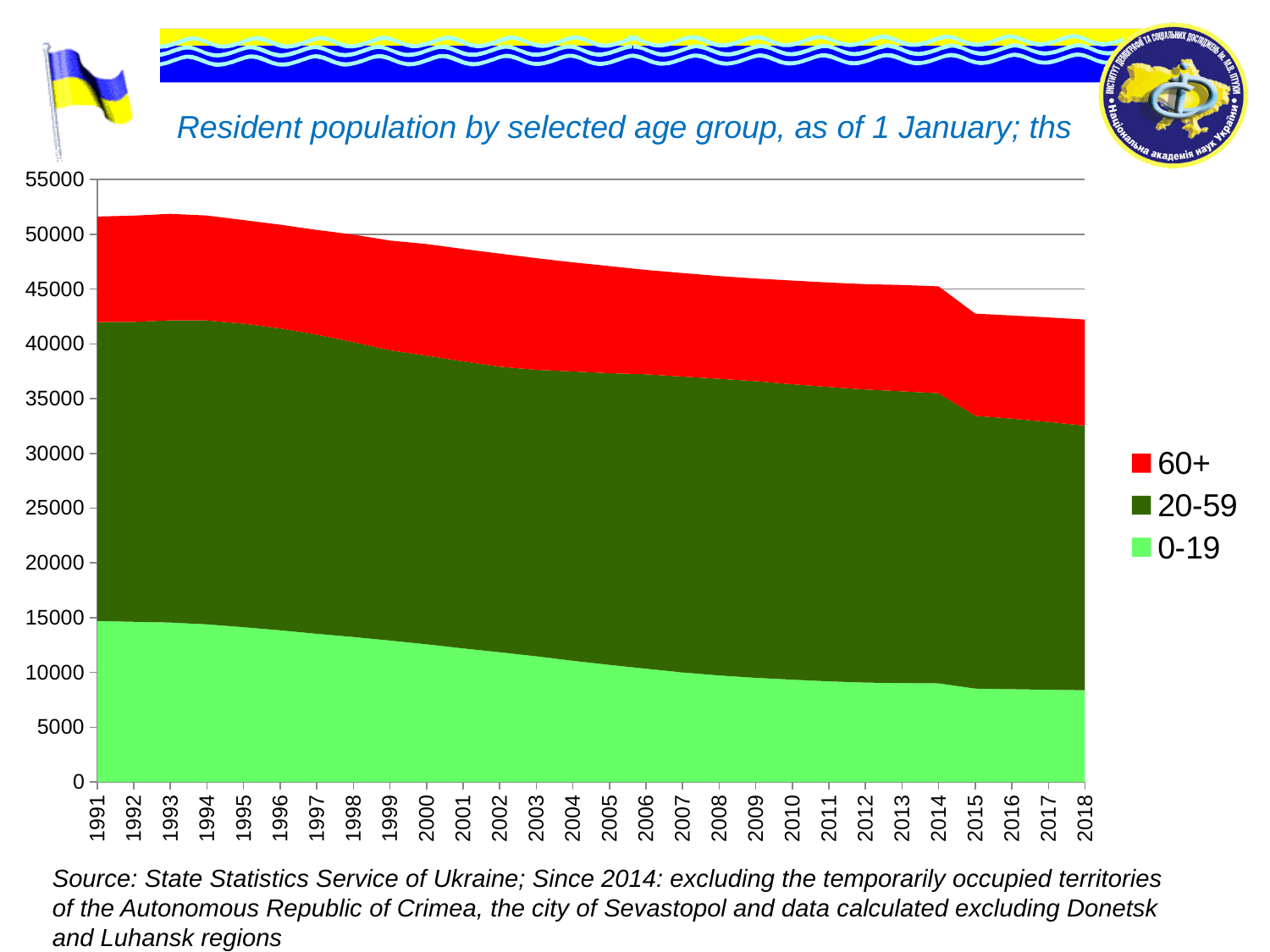
Is the total resident population in 2018 greater or less than 45000? less How many series does the legend list? 3 In 2018, which is larger: the 20-59 age group or the 0-19 age group? 20-59 Is the total resident population in 1991 greater or less than 50000? greater Which age group has the largest population throughout the period? 20-59 Which age group is shown in red? 60+ What is the title of the chart? Resident population by selected age group, as of 1 January; ths Is the total resident population in 2015 greater or less than 45000? less Does the total resident population rise or fall from 1991 to 2018? Fall What kind of chart is shown on the slide? Stacked area chart How many years are shown along the x axis? 28